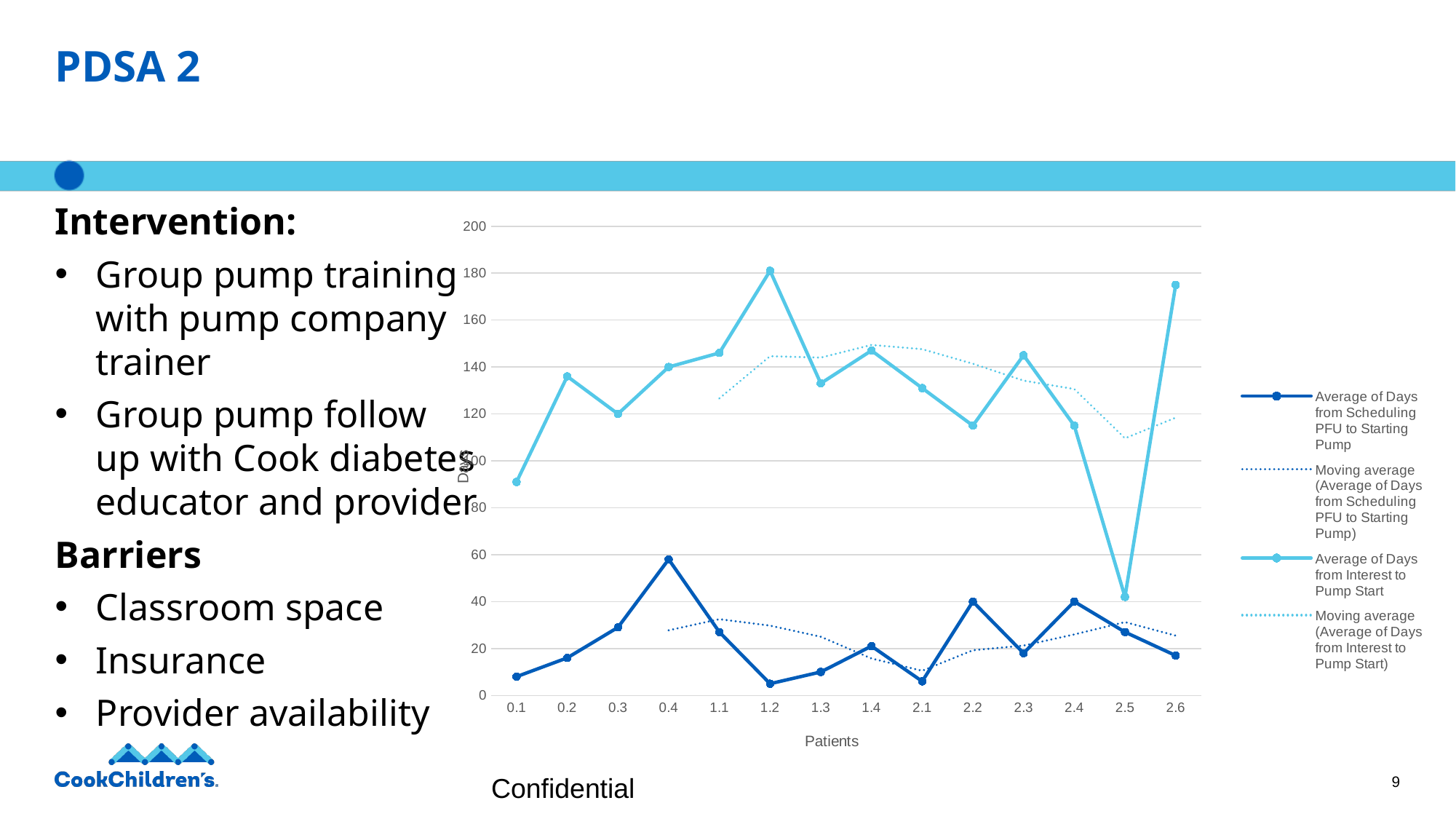
Is the value for 'Average of Days from Scheduling PFU to Starting Pump' at patient 0.4 greater or less than 40? greater How many series does the chart's legend list? 4 Is the value for 'Average of Days from Interest to Pump Start' at patient 2.5 greater or less than 60? less What kind of chart is shown on the slide? Line chart At which patient does the 'Average of Days from Scheduling PFU to Starting Pump' series reach its highest value? 0.4 What is the title of the x axis of the chart? Patients Is the value for 'Average of Days from Interest to Pump Start' at patient 1.2 greater or less than 160? greater At which patient does the 'Average of Days from Interest to Pump Start' series reach its highest value? 1.2 Does the 'Average of Days from Scheduling PFU to Starting Pump' series rise or fall from patient 0.1 to patient 0.4? Rise At which patient does the 'Average of Days from Interest to Pump Start' series reach its lowest value? 2.5 At patient 0.4, which series has the larger value: 'Average of Days from Interest to Pump Start' or 'Average of Days from Scheduling PFU to Starting Pump'? Average of Days from Interest to Pump Start How many patient categories are shown along the x axis of the chart? 14